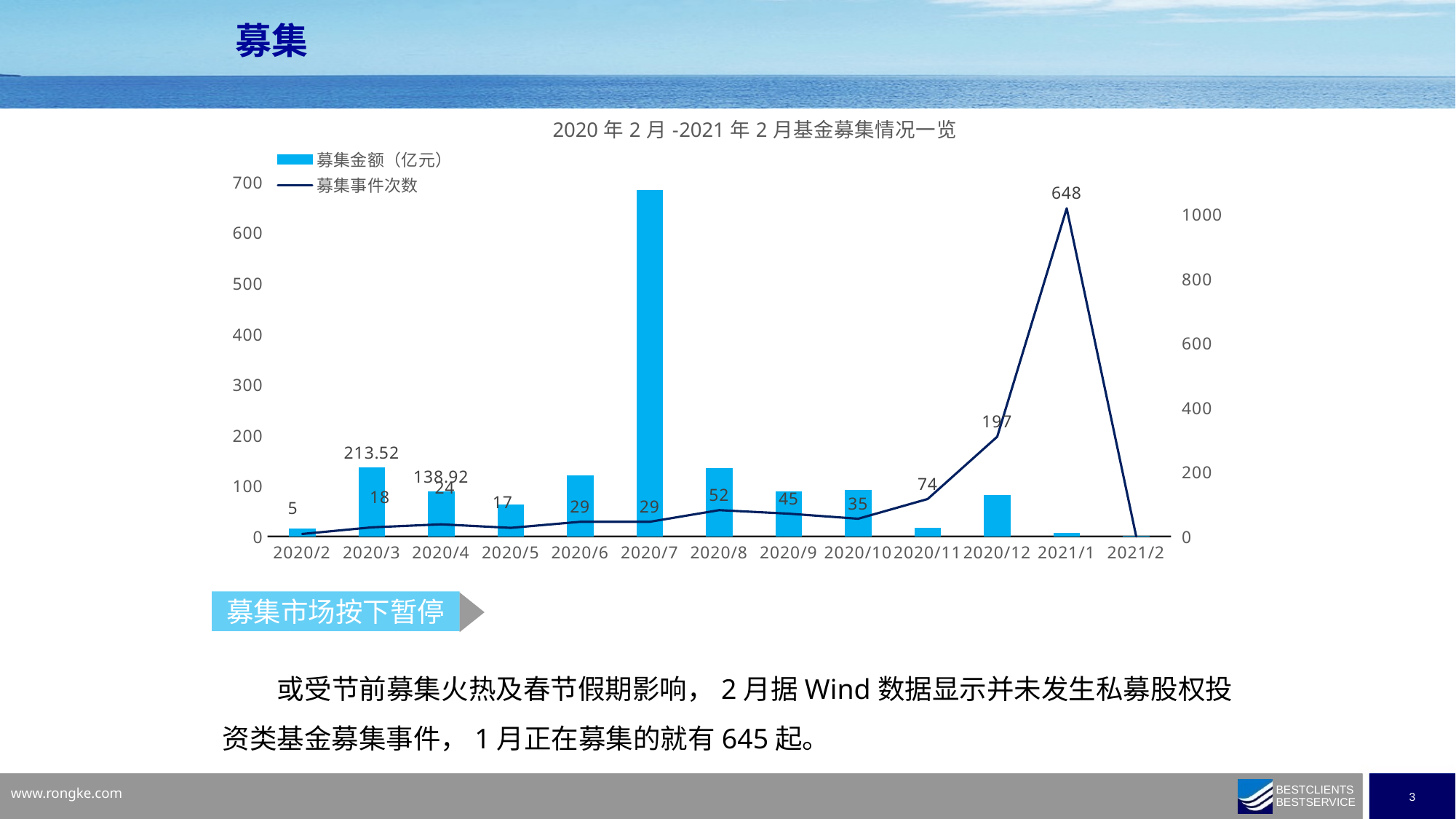
What is the 募集事件次数 value for 2020/12? 197 What is the difference in 募集事件次数 between 2021/1 and 2020/12? 451 How many series does the legend list? 2 Which month has the tallest 募集金额（亿元） bar? 2020/7 Which month has a higher 募集事件次数, 2020/8 or 2020/9? 2020/8 What is the 募集金额（亿元） value for 2020/3? 213.52 What is the difference in 募集金额（亿元） between 2020/3 and 2020/4? 74.6 Is the 募集金额（亿元） bar for 2020/7 greater or less than 600 on the left axis? greater Which month has the highest 募集事件次数? 2021/1 How many months are shown on the x axis? 13 What is the 募集金额（亿元） value for 2020/4? 138.92 What is the 募集事件次数 value for 2021/1? 648